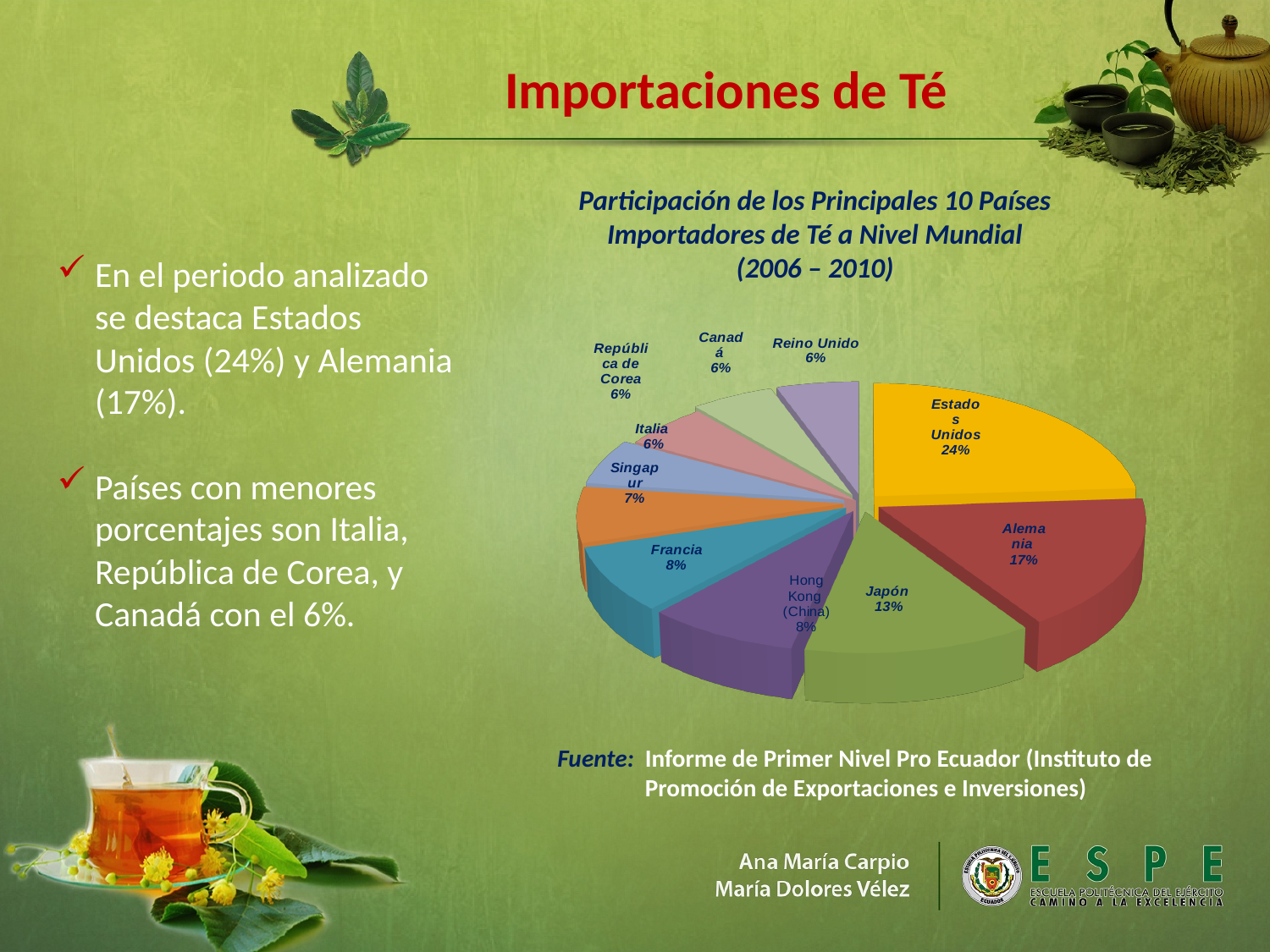
What is the difference between the shares of Japón and Francia? 5% Which has a larger share, Francia or Singapur? Francia What is the share for Hong Kong (China) in the pie chart? 8% What is the share for Estados Unidos in the pie chart? 24% What is the share for Japón in the pie chart? 13% What type of chart is shown on the slide? Pie chart What is the share for Alemania in the pie chart? 17% What is the title of the pie chart? Participación de los Principales 10 Países Importadores de Té a Nivel Mundial (2006 – 2010) What is the share for Singapur in the pie chart? 7% Which country has the largest share in the pie chart? Estados Unidos What is the difference between the shares of Estados Unidos and Alemania? 7% How many slices does the pie chart have? 10